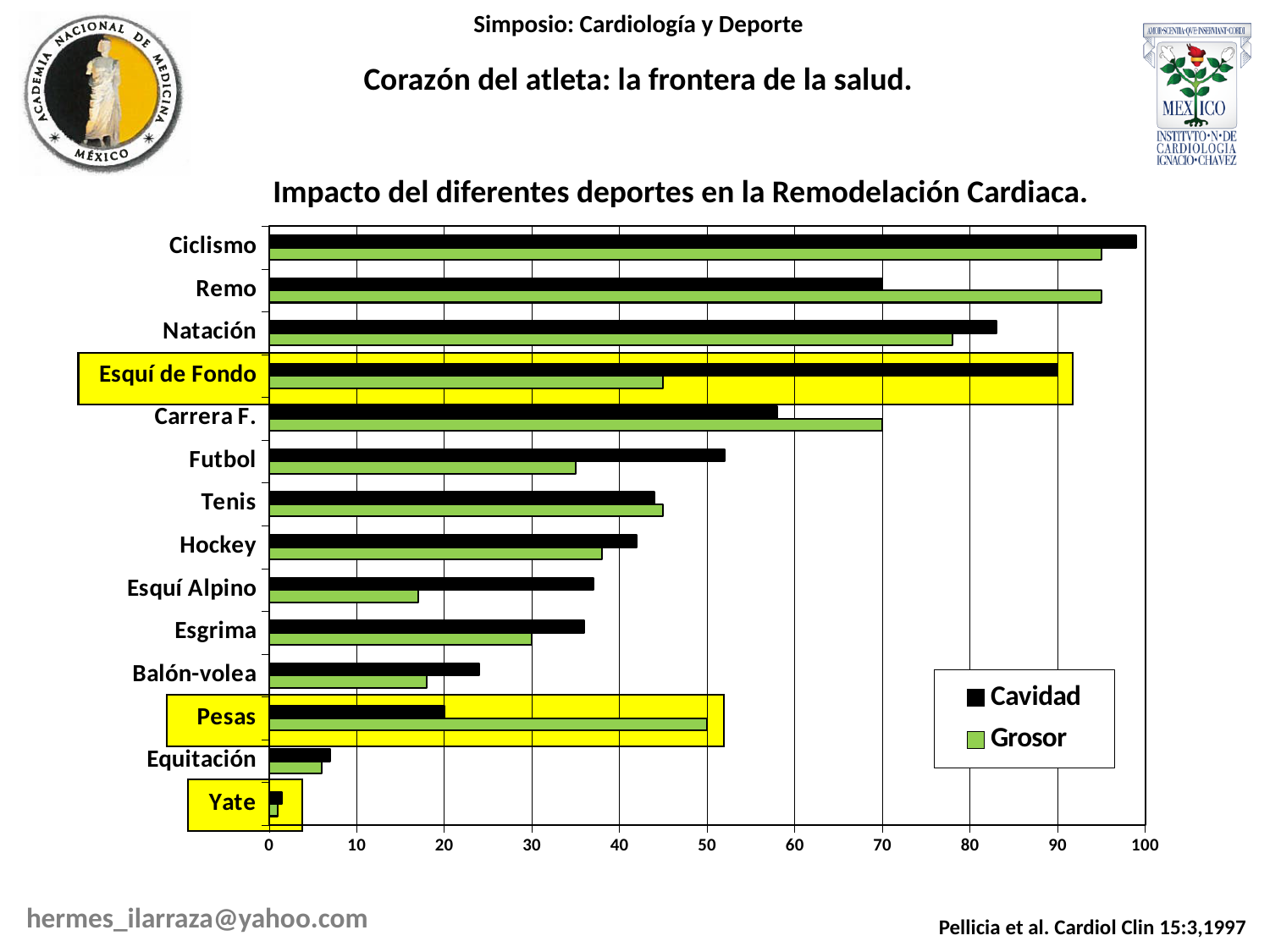
How many sports (categories) are plotted on the chart? 14 Which sport has the highest Cavidad value? Ciclismo What is the title of the chart? Impacto del diferentes deportes en la Remodelación Cardiaca. Which sport has the lowest Cavidad value? Yate What kind of chart is shown on the slide? bar chart Is the Cavidad value for Natación greater or less than 80? greater Which sport has the lowest Grosor value? Yate Is the Grosor value for Esquí Alpino greater or less than 20? less Is the Cavidad value for Futbol greater or less than 50? greater For Pesas, which is larger, the Cavidad value or the Grosor value? Grosor How many series does the legend list? 2 For Esquí de Fondo, which is larger, the Cavidad value or the Grosor value? Cavidad